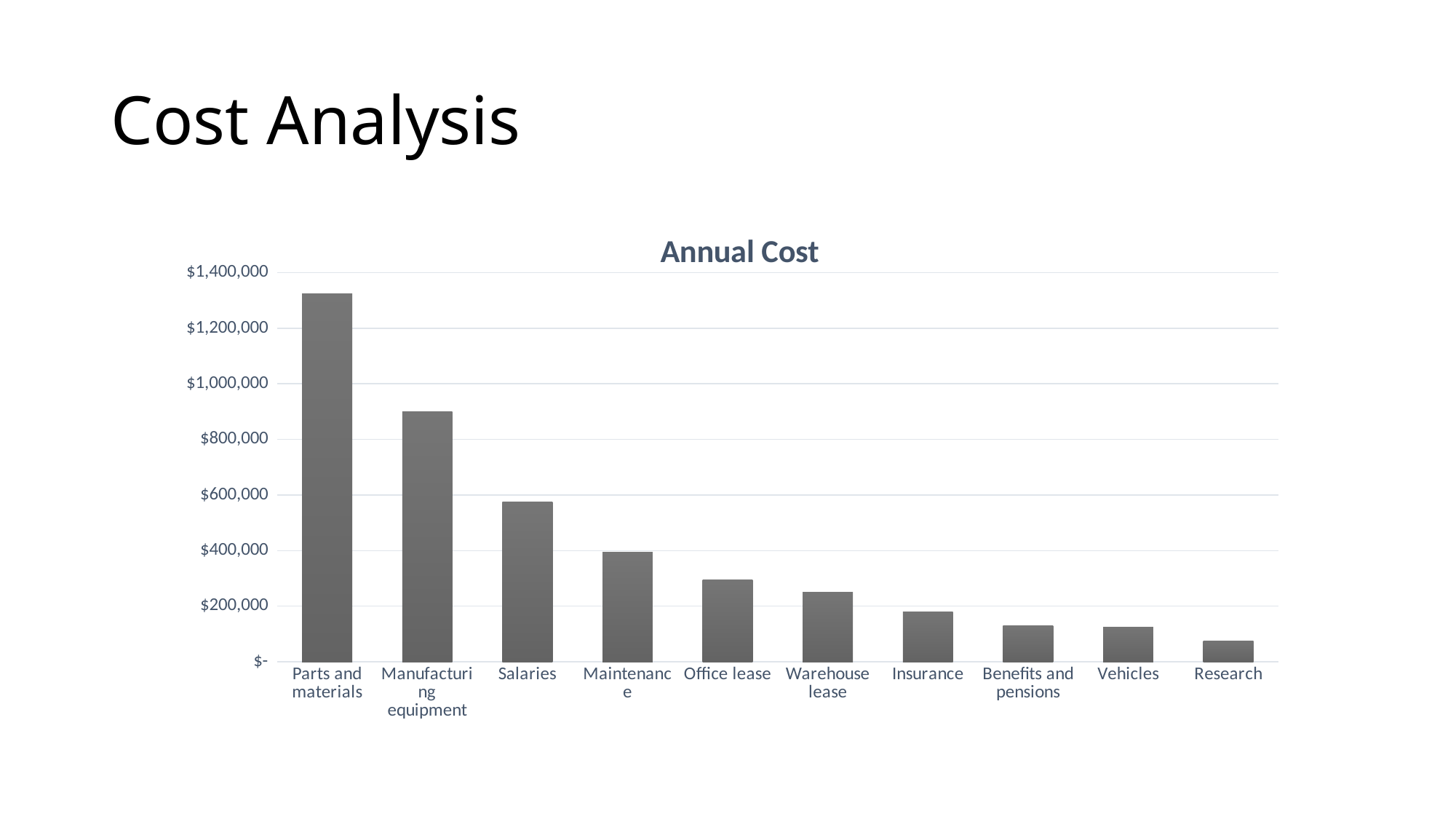
How many cost categories are plotted in the chart? 10 What kind of chart is shown on the slide? bar chart What is the title of the chart? Annual Cost Which category has the highest annual cost? Parts and materials Which is larger, the value for Salaries or the value for Maintenance? Salaries Is the value for Parts and materials greater or less than $1,200,000? greater Which category has the lowest annual cost? Research Is the value for Manufacturing equipment greater or less than $800,000? greater Is the value for Research greater or less than $200,000? less Do the values rise or fall moving from left to right along the x axis? fall